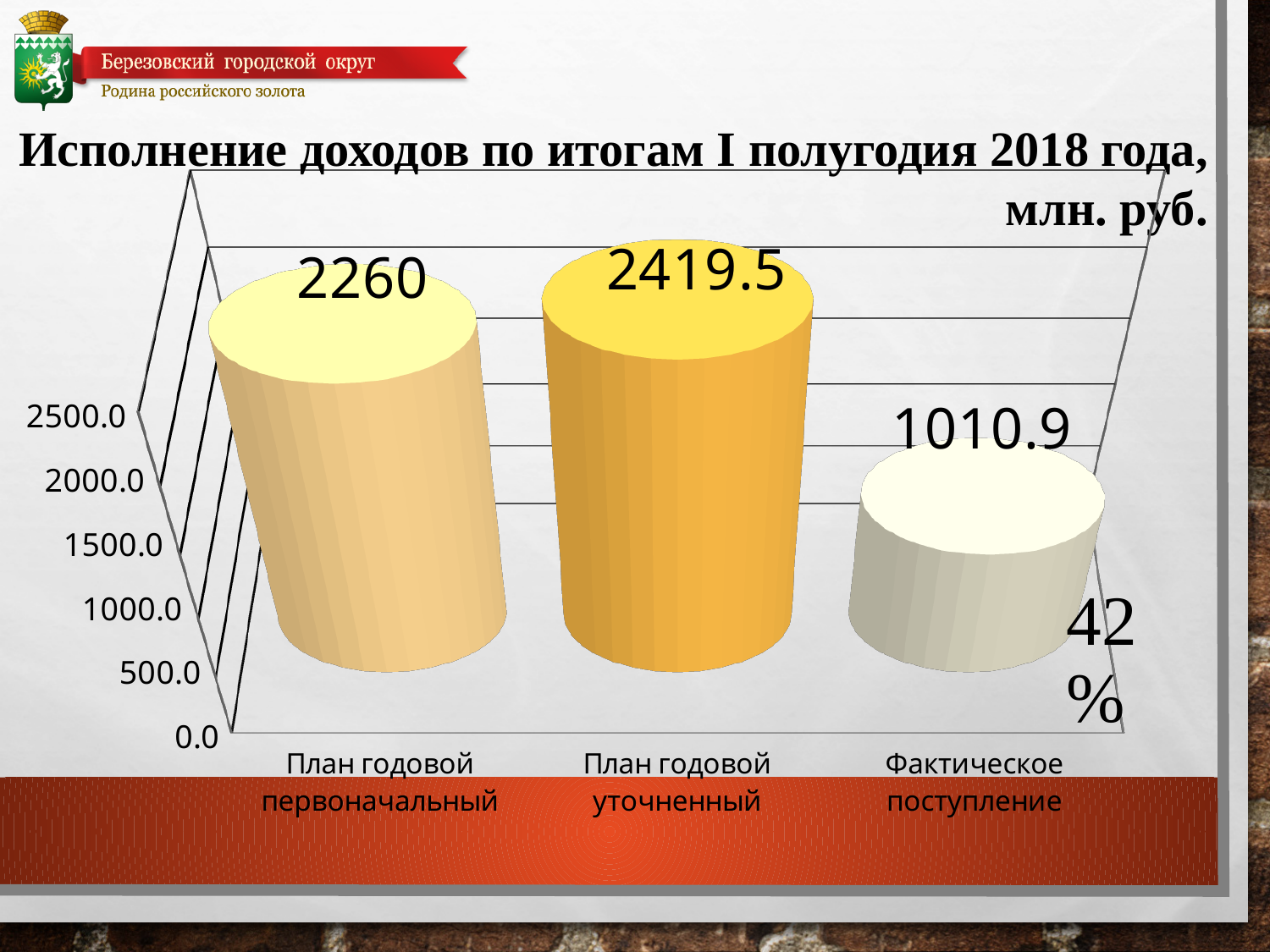
Is the value for «Фактическое поступление» greater or less than 1500.0? less Which category has the highest value? План годовой уточненный What is the difference between «План годовой уточненный» and «Фактическое поступление»? 1408.6 What percentage is printed next to the «Фактическое поступление» bar? 42% What is the value for «План годовой уточненный»? 2419.5 What kind of chart is shown on the slide? bar chart What is the difference between «План годовой уточненный» and «План годовой первоначальный»? 159.5 Which category has the lowest value? Фактическое поступление What is the value for «Фактическое поступление»? 1010.9 Which is larger: «План годовой первоначальный» or «Фактическое поступление»? План годовой первоначальный How many categories are shown in the chart? 3 What is the value for «План годовой первоначальный»? 2260